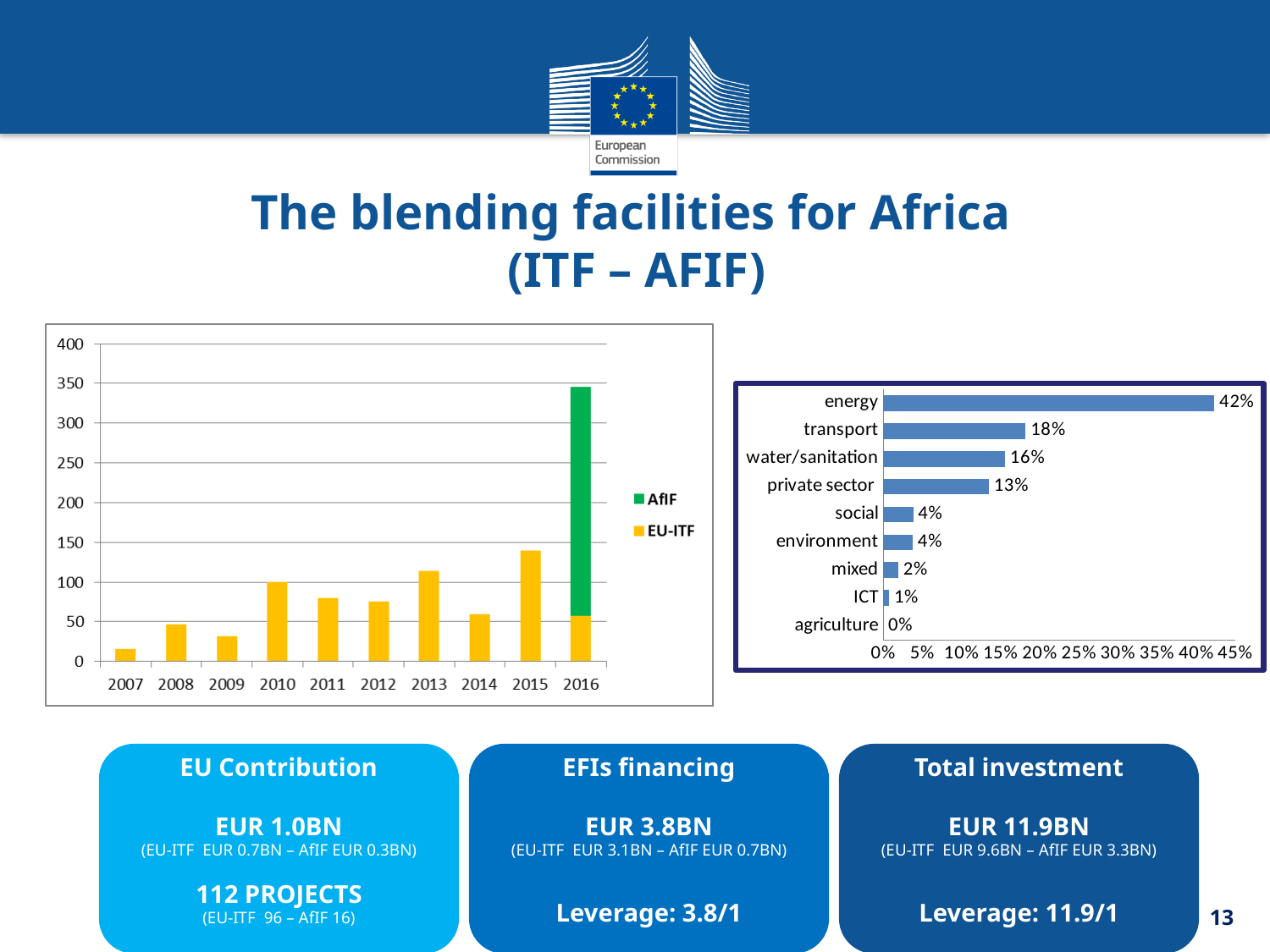
How many sectors are listed in the right-hand chart? 9 In the right-hand chart, which sector has the highest percentage? energy In the left-hand chart, which series is shown in green? AfIF In the right-hand chart, which sector has the lowest percentage? agriculture How many series does the legend of the left-hand chart list? 2 In the left-hand chart, which year has the tallest bar? 2016 In the left-hand chart, is the value for 2015 greater or less than 100? greater What type of chart is the left-hand chart? bar chart In the right-hand chart, what percentage is shown for energy? 42% In the right-hand chart, what percentage is shown for water/sanitation? 16% In the right-hand chart, what is the difference between the percentages for transport and private sector? 5% In the right-hand chart, which is larger, the percentage for mixed or the percentage for ICT? mixed